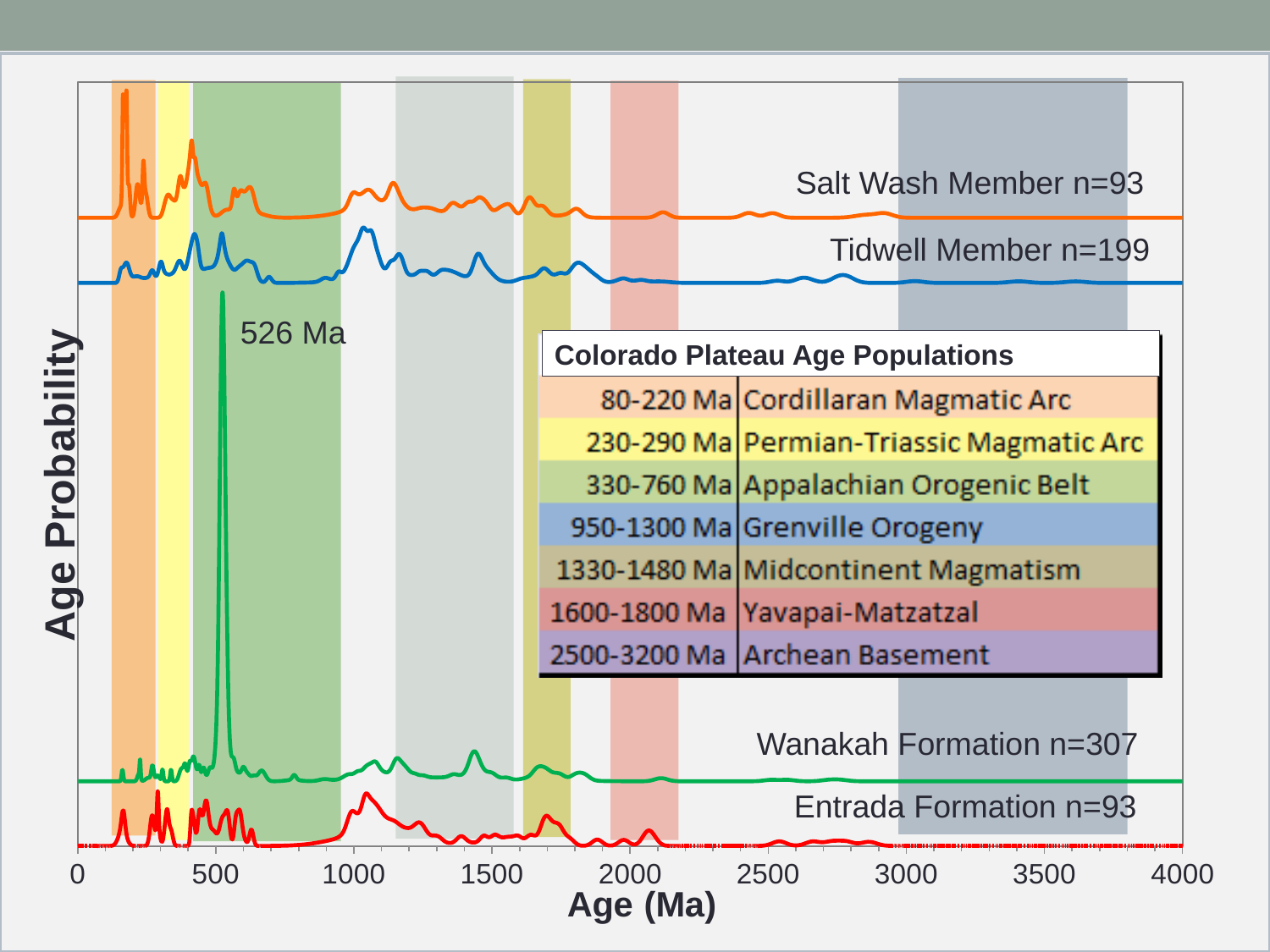
In the Colorado Plateau Age Populations table, what age range is given for the Grenville Orogeny? 950-1300 Ma What is the label of the y axis? Age Probability What is the sample size n for the Wanakah Formation? 307 What kind of chart is shown on the slide? line chart Which has a larger sample size, the Tidwell Member or the Salt Wash Member? Tidwell Member What is the difference between the sample sizes of the Wanakah Formation and the Tidwell Member? 108 What age is labeled at the tallest peak of the Wanakah Formation curve? 526 Ma How many age populations are listed in the Colorado Plateau Age Populations table? 7 What is the label of the x axis? Age (Ma) How many sample series (formations/members) are plotted on the chart? 4 Which series has the largest sample size n? Wanakah Formation What is the sample size n for the Tidwell Member? 199